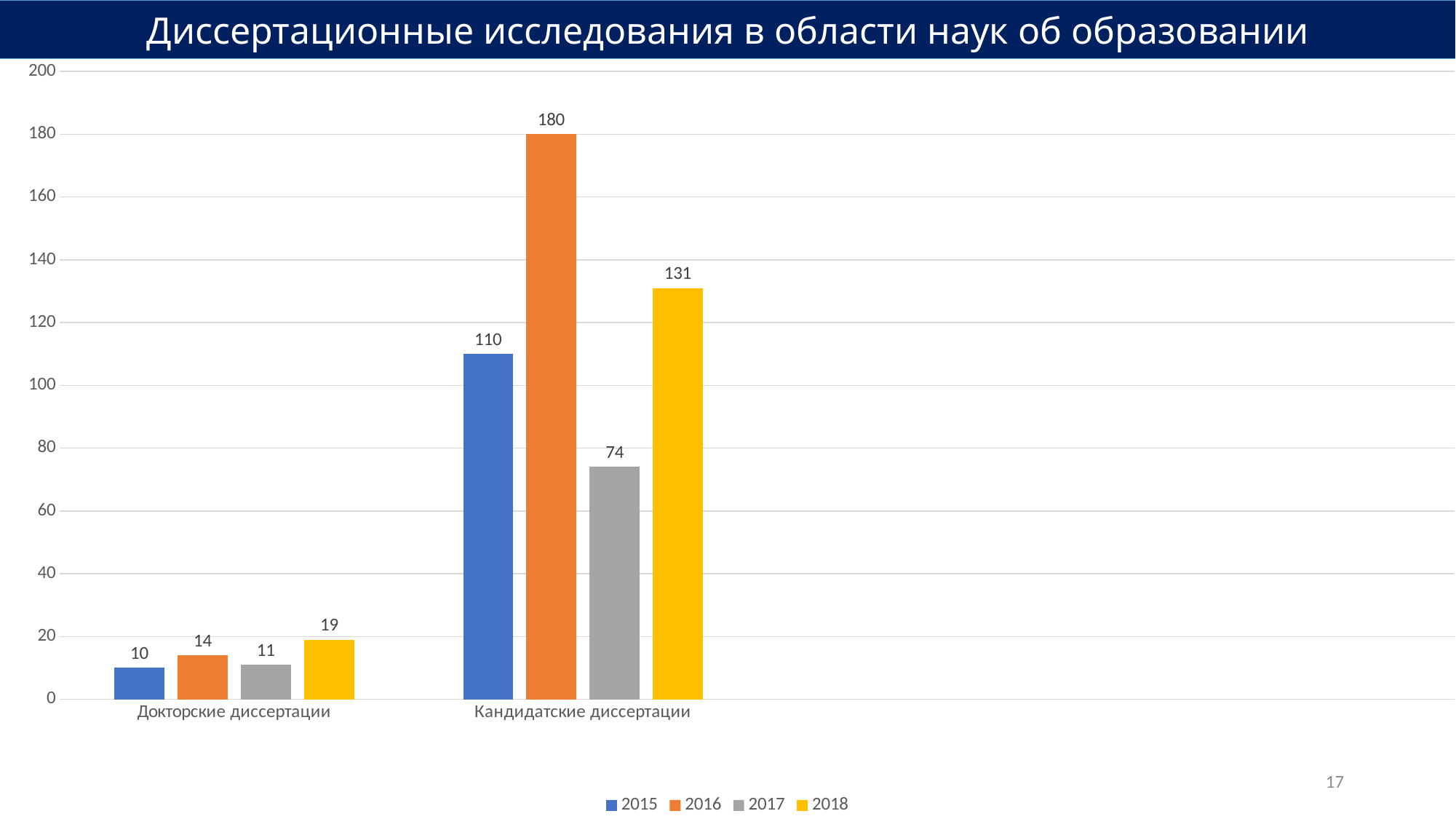
Which year has the lowest value for Докторские диссертации? 2015 What is the value for 2017 in the Кандидатские диссертации category? 74 Which is larger for Кандидатские диссертации: the 2015 value or the 2018 value? 2018 How many series does the legend list? 4 What is the value for 2018 in the Докторские диссертации category? 19 What is the value for 2016 in the Кандидатские диссертации category? 180 What is the difference between the 2016 and 2017 values for Кандидатские диссертации? 106 Which year has the highest value for Кандидатские диссертации? 2016 What kind of chart is shown on the slide? Bar chart Is the value for 2018 in Кандидатские диссертации greater or less than 120? greater What is the title of the chart? Диссертационные исследования в области наук об образовании What is the difference between the 2018 and 2015 values for Докторские диссертации? 9